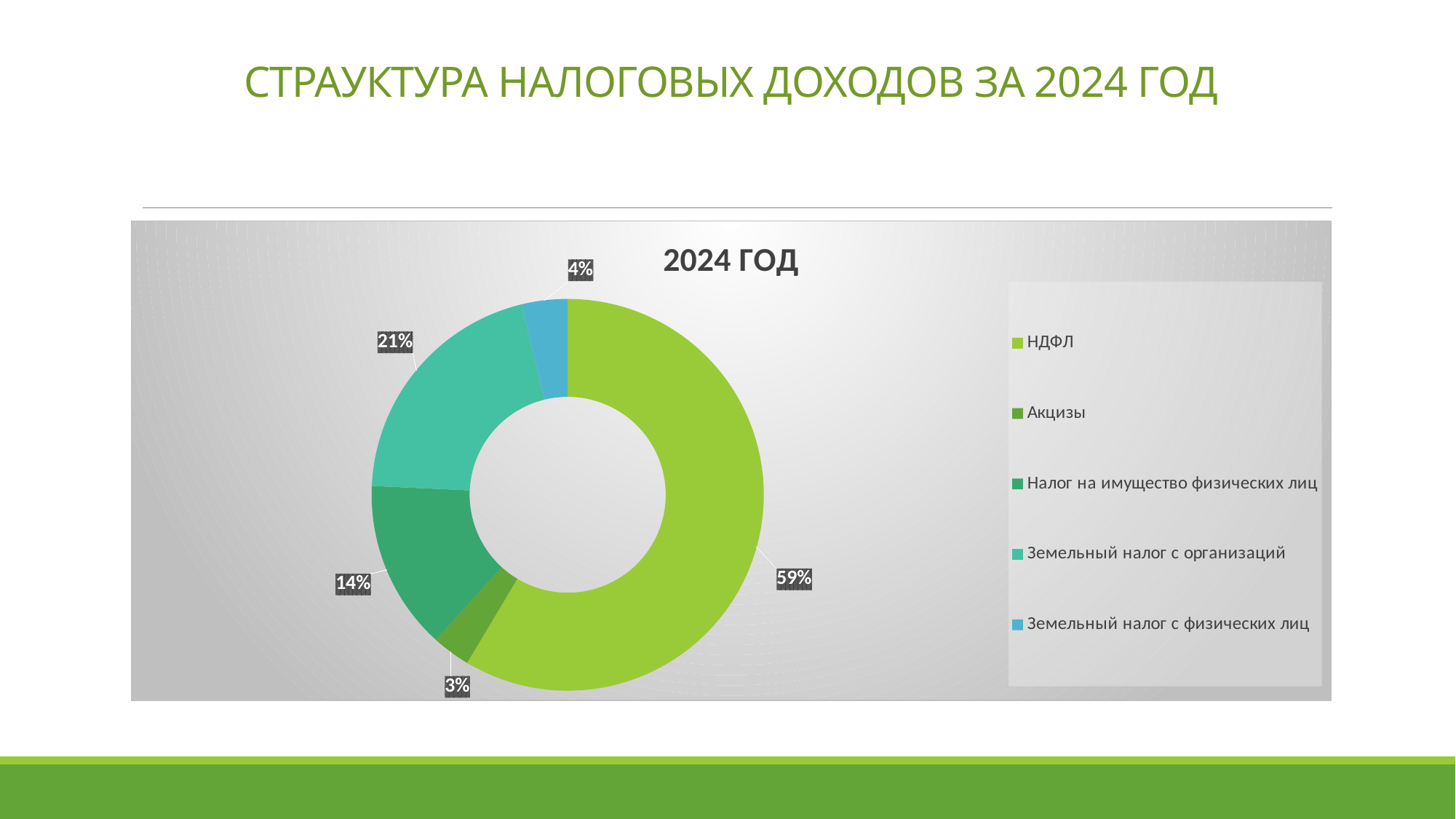
How many categories does the legend list? 5 What share of tax revenue does НДФЛ account for? 59% What is the difference in percentage points between НДФЛ and Земельный налог с организаций? 38 percentage points Which category has the smallest share? Акцизы Which category has the largest share? НДФЛ What type of chart is shown on the slide? Doughnut (pie) chart What share is shown for Налог на имущество физических лиц? 14% What is the chart's title? 2024 ГОД What share is shown for Акцизы? 3% What share is shown for Земельный налог с организаций? 21% What share is shown for Земельный налог с физических лиц? 4% Which is larger: the share for Налог на имущество физических лиц or the share for Земельный налог с организаций? Земельный налог с организаций